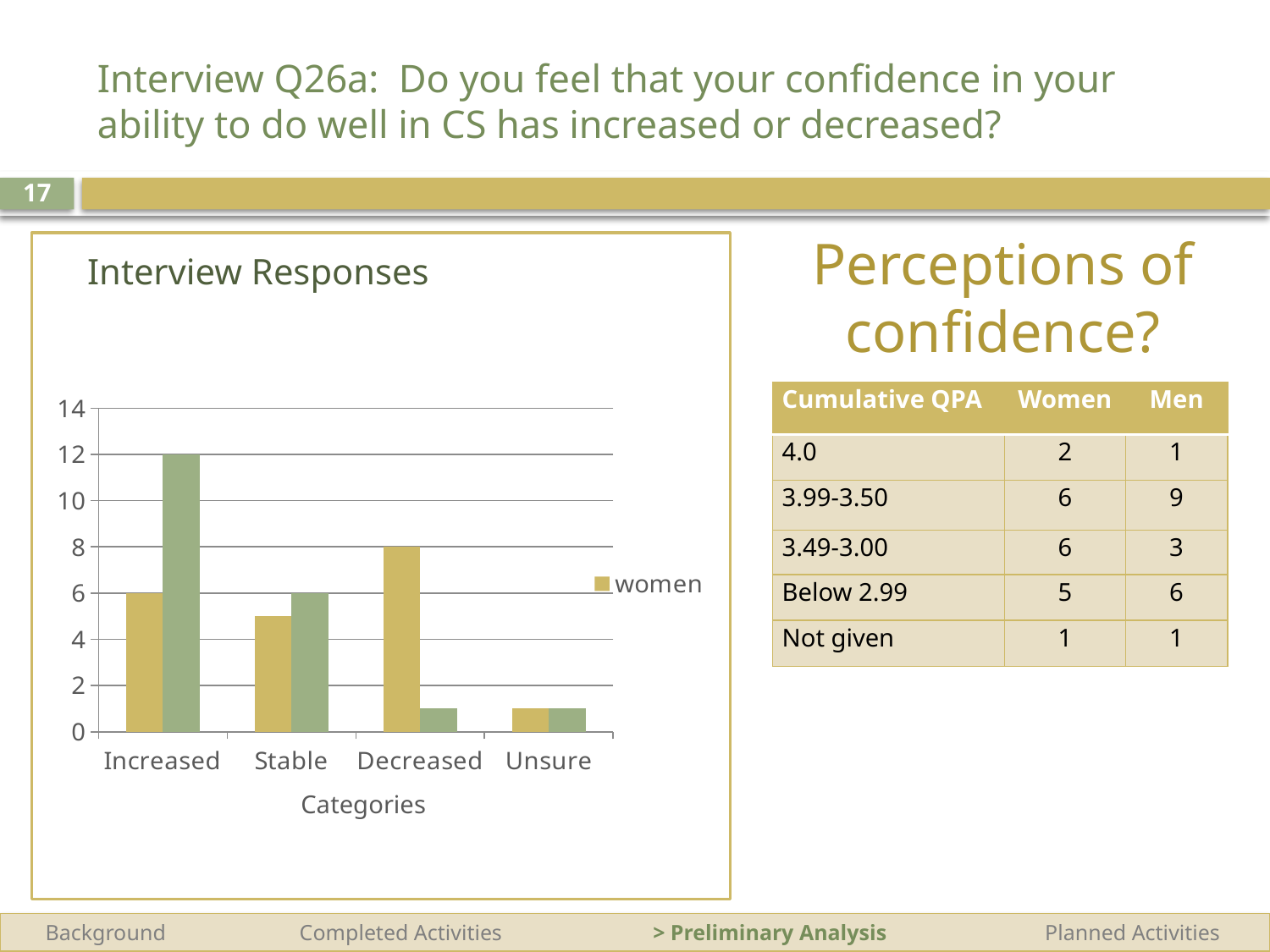
Which category has the lowest value for the women series? Unsure What is the difference between the green bar and the women bar for the Increased category? 6 How many categories are shown on the x axis of the Interview Responses chart? 4 How many series does the legend of the Interview Responses chart list? 1 Is the green bar for Decreased greater or less than 2? less Which category has the highest value for the women series? Decreased What is the value of the women series for the Increased category? 6 What is the value of the green bar for the Increased category? 12 What is the value of the women series for the Decreased category? 8 What type of chart is shown under the title "Interview Responses"? bar chart What is the value of the green bar for the Stable category? 6 Is the value of the women series for Stable greater or less than 4? greater